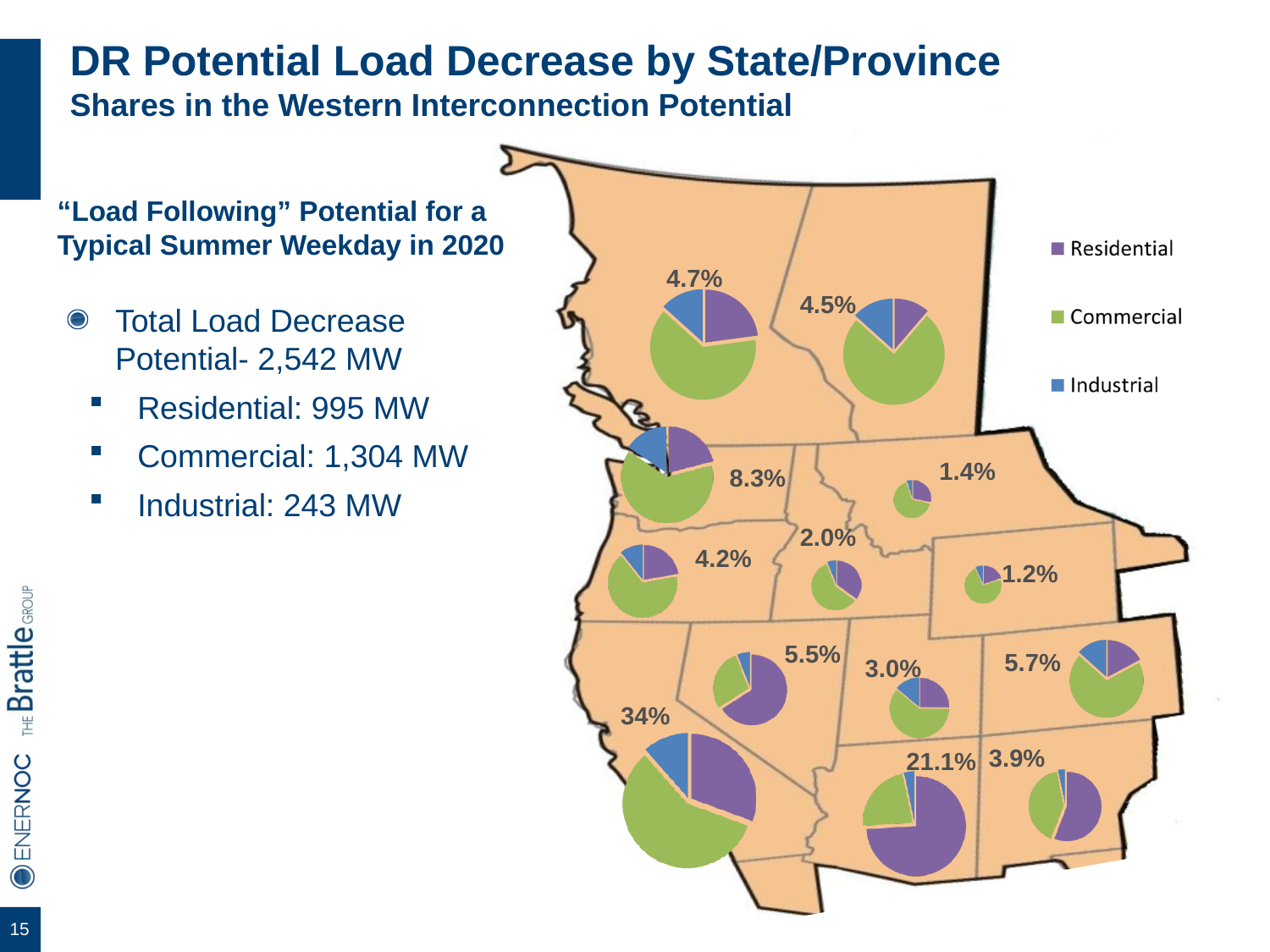
What is the total load decrease potential stated on the slide? 2,542 MW Which series makes up the largest slice of the 21.1% pie chart on the map? Residential Which is larger, the 5.5% share or the 5.7% share shown on the map? 5.7% How many series does the legend on the map list? 3 How many pie charts are shown on the map? 13 What is the difference between the largest share (34%) and the second-largest share (21.1%) on the map? 12.9% What kind of chart is used on the map to show each state/province's load decrease potential? pie chart What share is labelled on the pie chart in the top-left (northwestern-most) province on the map? 4.7% Which colour represents Industrial in the map legend? blue Which series makes up the largest slice of the 34% pie chart on the map? Commercial What is the smallest share percentage labelled on the map? 1.2% What is the largest share percentage labelled on the map? 34%